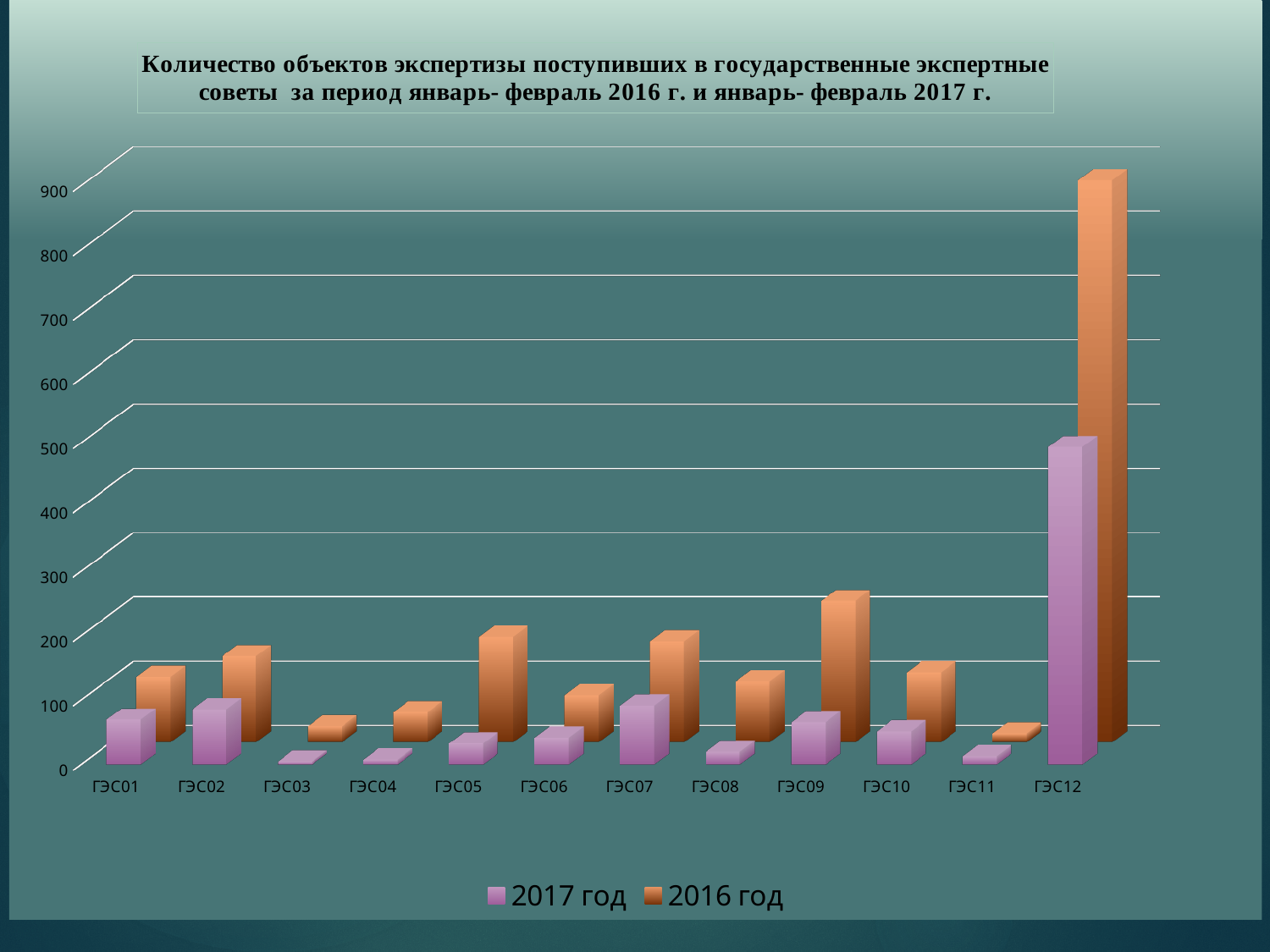
Which is larger for the 2017 год series: ГЭС07 or ГЭС11? ГЭС07 Which category has the lowest value for the 2016 год series? ГЭС11 Is the 2016 год value for ГЭС09 greater or less than 100? greater What are the two entries listed in the legend? 2017 год and 2016 год Which category has the highest value for the 2016 год series? ГЭС12 Is the 2016 год value for ГЭС11 greater or less than 100? less Which category has the highest value for the 2017 год series? ГЭС12 How many series does the legend list? 2 Is the 2016 год value for ГЭС12 greater or less than 800? greater How many categories (ГЭС) are shown on the x axis? 12 What kind of chart is shown on the slide? Bar chart For ГЭС12, which series has the larger value, 2016 год or 2017 год? 2016 год